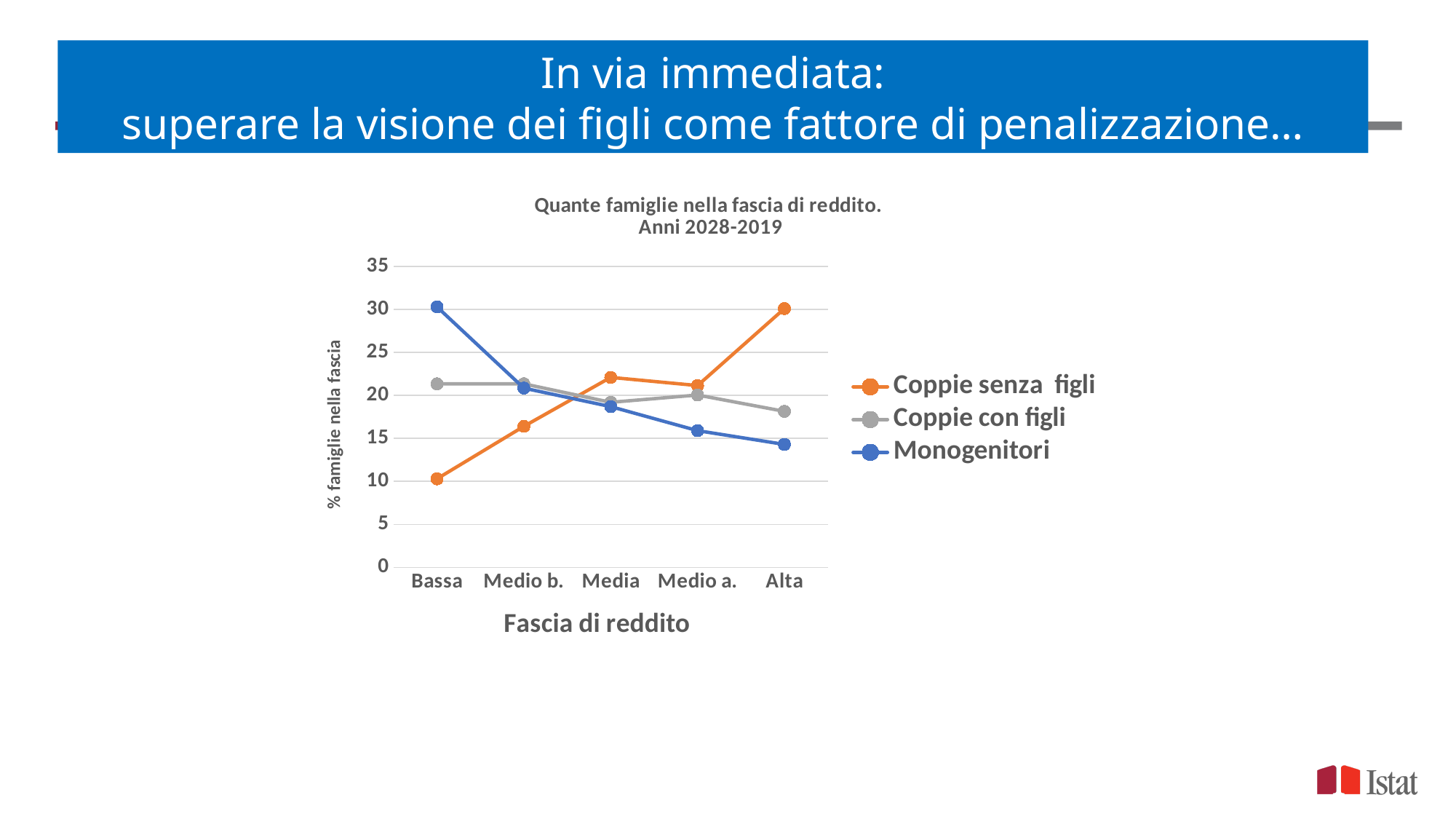
At Alta, which series has the larger value: Coppie senza figli or Monogenitori? Coppie senza figli In which income band is the value for Monogenitori highest? Bassa Do the values for Monogenitori rise or fall from Bassa to Alta? Fall At Bassa, which series has the larger value: Monogenitori or Coppie con figli? Monogenitori How many income bands (categories) are shown on the x axis? 5 What kind of chart is shown on the slide? Line chart In which income band is the value for Coppie senza figli highest? Alta Is the value for Monogenitori at Bassa greater or less than 25? greater What is the label of the x axis? Fascia di reddito Is the value for Coppie senza figli at Bassa greater or less than 15? less How many series does the legend list? 3 In which income band is the value for Coppie senza figli lowest? Bassa